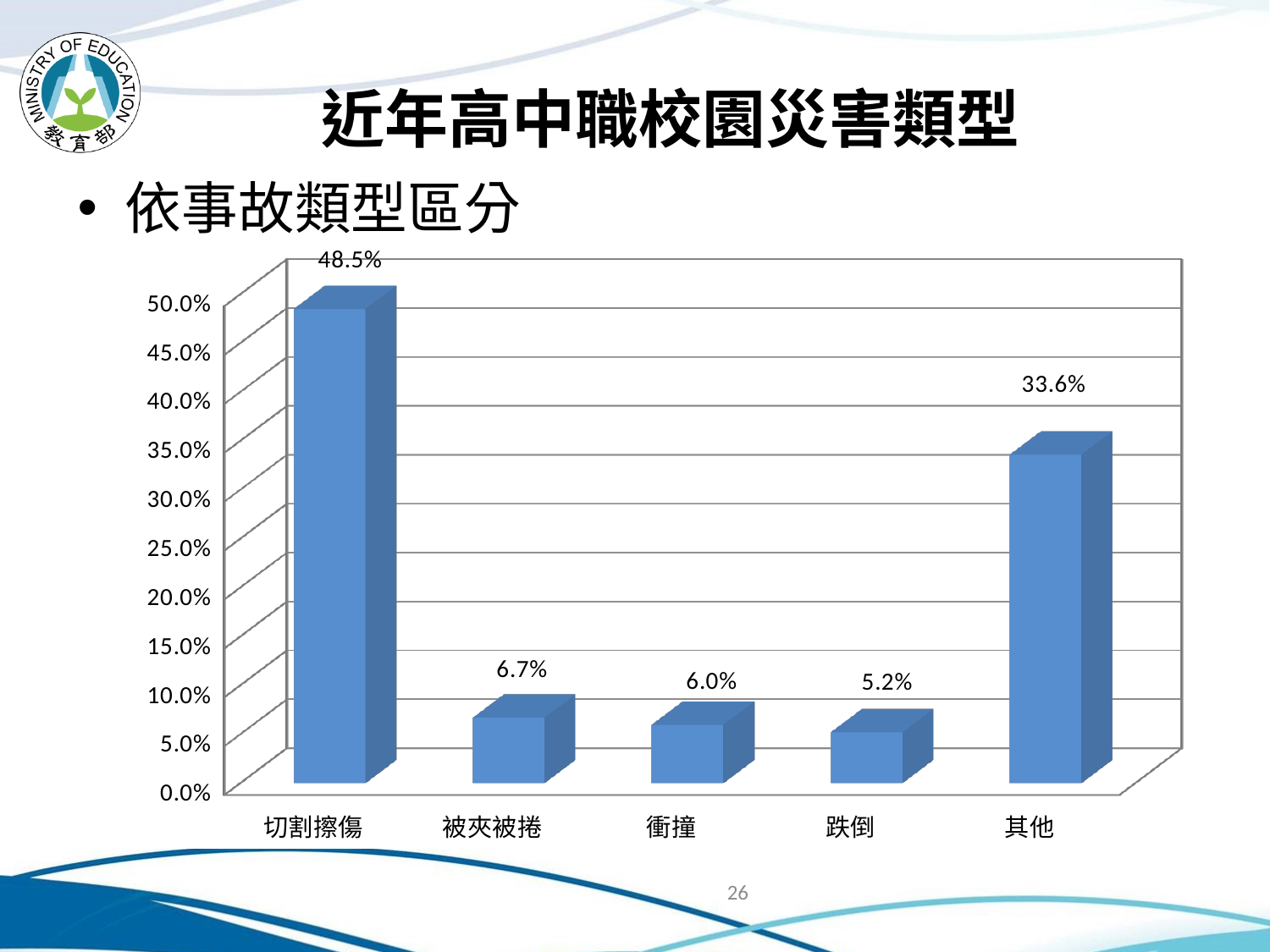
What is the value for 被夾被捲? 6.7% Is the value for 其他 greater or less than 30.0%? greater Which is larger, the value for 衝撞 or the value for 跌倒? 衝撞 Which category has the highest value? 切割擦傷 What is the value for 其他? 33.6% What is the value for 切割擦傷? 48.5% What is the value for 跌倒? 5.2% Which category has the lowest value? 跌倒 What kind of chart is shown on the slide? bar chart How many categories are shown on the x axis? 5 What is the difference between the values for 切割擦傷 and 其他? 14.9% What is the difference between the values for 被夾被捲 and 衝撞? 0.7%